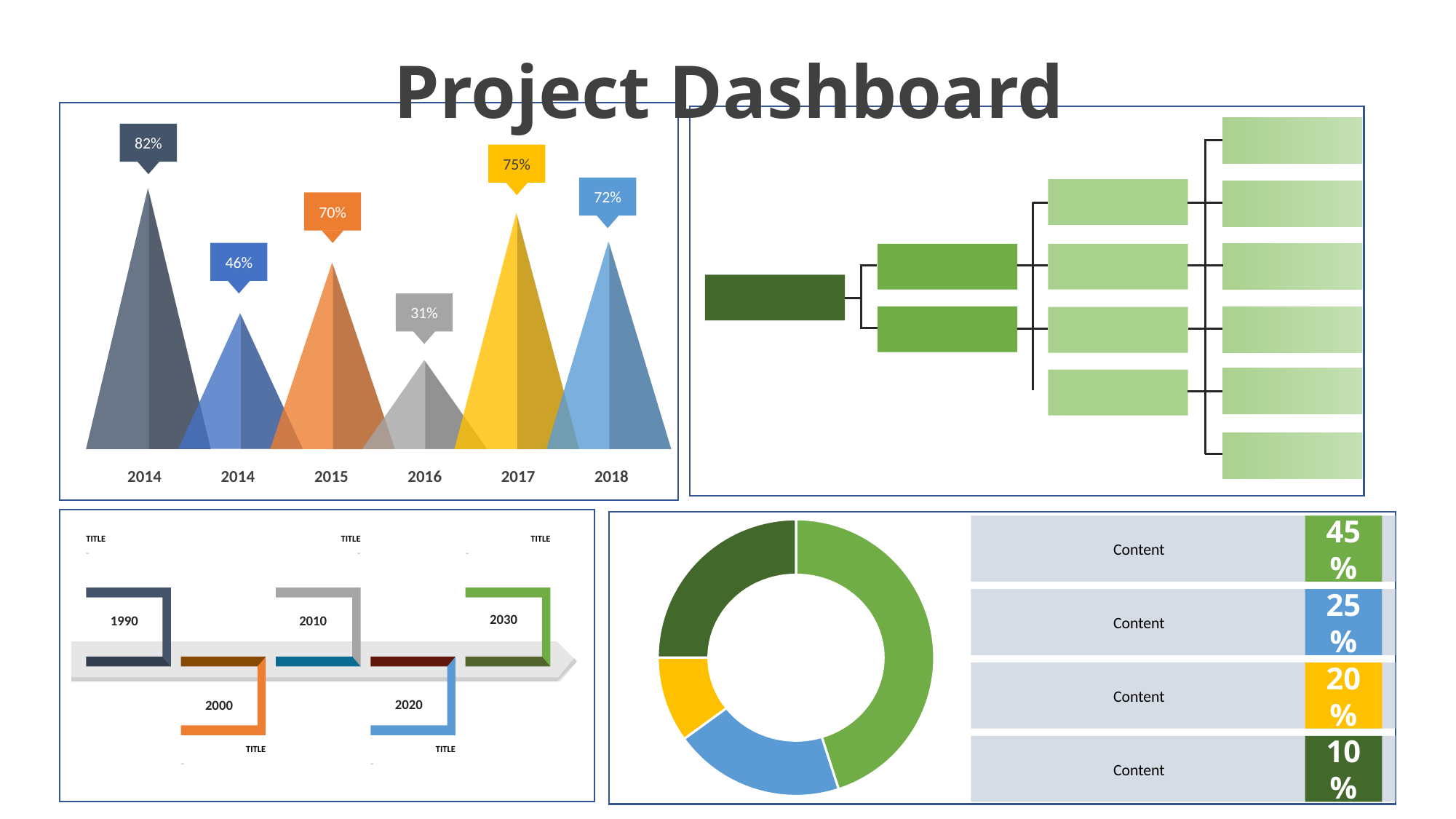
In the top-left peak chart, which category has the lowest value? 2016 In the top-left peak chart, what is the value for 2015? 70% In the top-left peak chart, what is the difference between the values for 2017 and 2016? 44 percentage points In the bottom-right donut chart, what is the largest share shown? 45% In the top-left peak chart, what is the value for 2018? 72% In the bottom-right donut chart, how many slices are there? 4 In the top-left peak chart, what is the value for 2016? 31% How many peaks (categories) are shown in the top-left peak chart? 6 In the top-left peak chart, which is larger, the value for 2015 or the value for 2018? 2018 In the top-left peak chart, what is the value for 2017? 75% What kind of chart is shown in the bottom-right panel? Donut chart In the top-left peak chart, what is the highest value shown? 82%